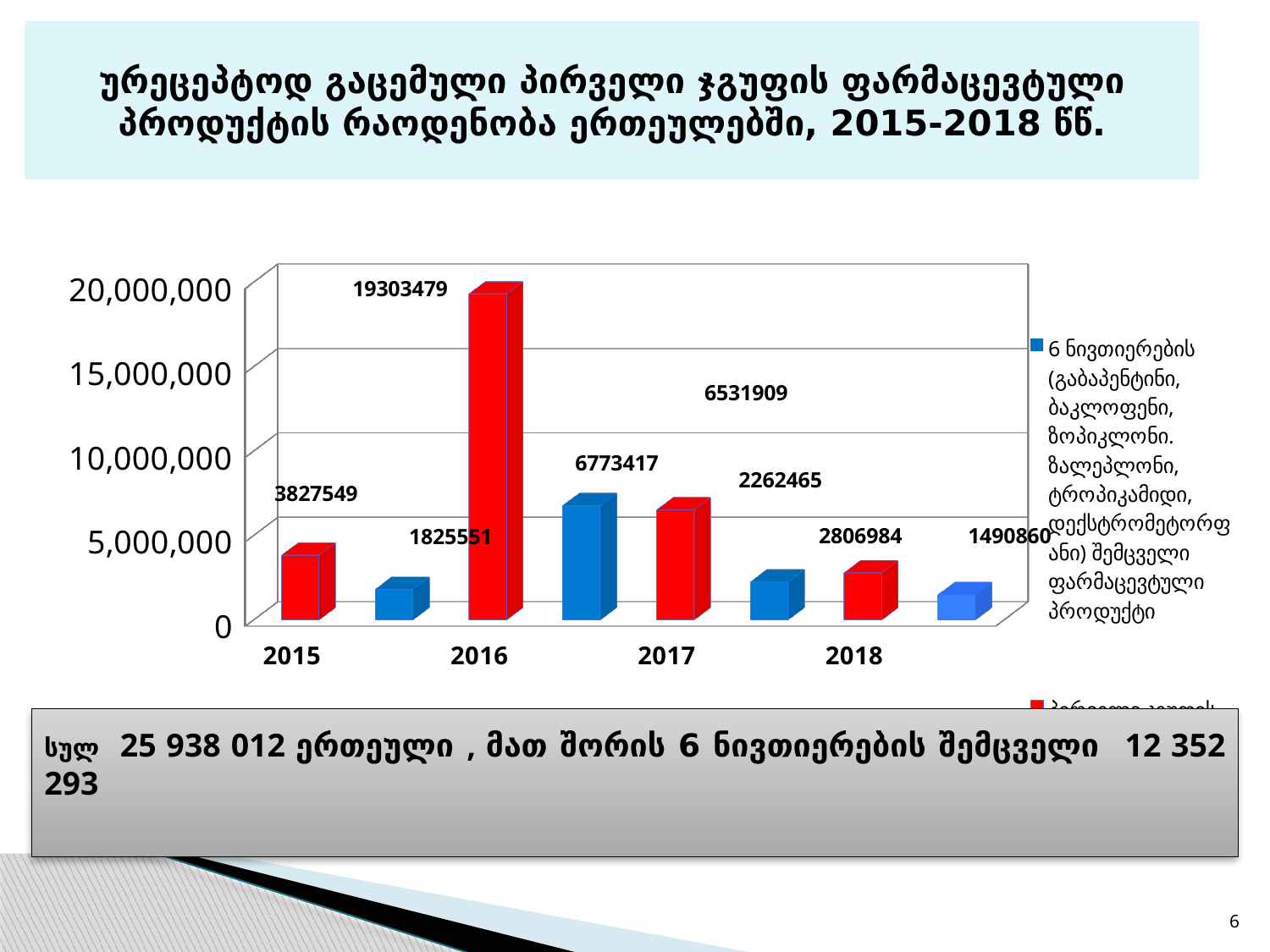
What is the difference between the red bar and the blue bar for 2015? 2001998 Which is larger in 2017, the red bar or the blue bar? the red bar From 2016 to 2018, do the red bars rise or fall? fall Which year has the lowest blue bar? 2018 How many years are shown on the x axis? 4 What kind of chart is shown on the slide? bar chart What is the value of the red bar for 2015? 3827549 What is the value of the red bar for 2017? 6531909 Which year has the highest red bar? 2016 What is the value of the red bar for 2016? 19303479 What is the value of the blue bar for 2018? 1490860 What is the value of the blue bar for 2016? 6773417